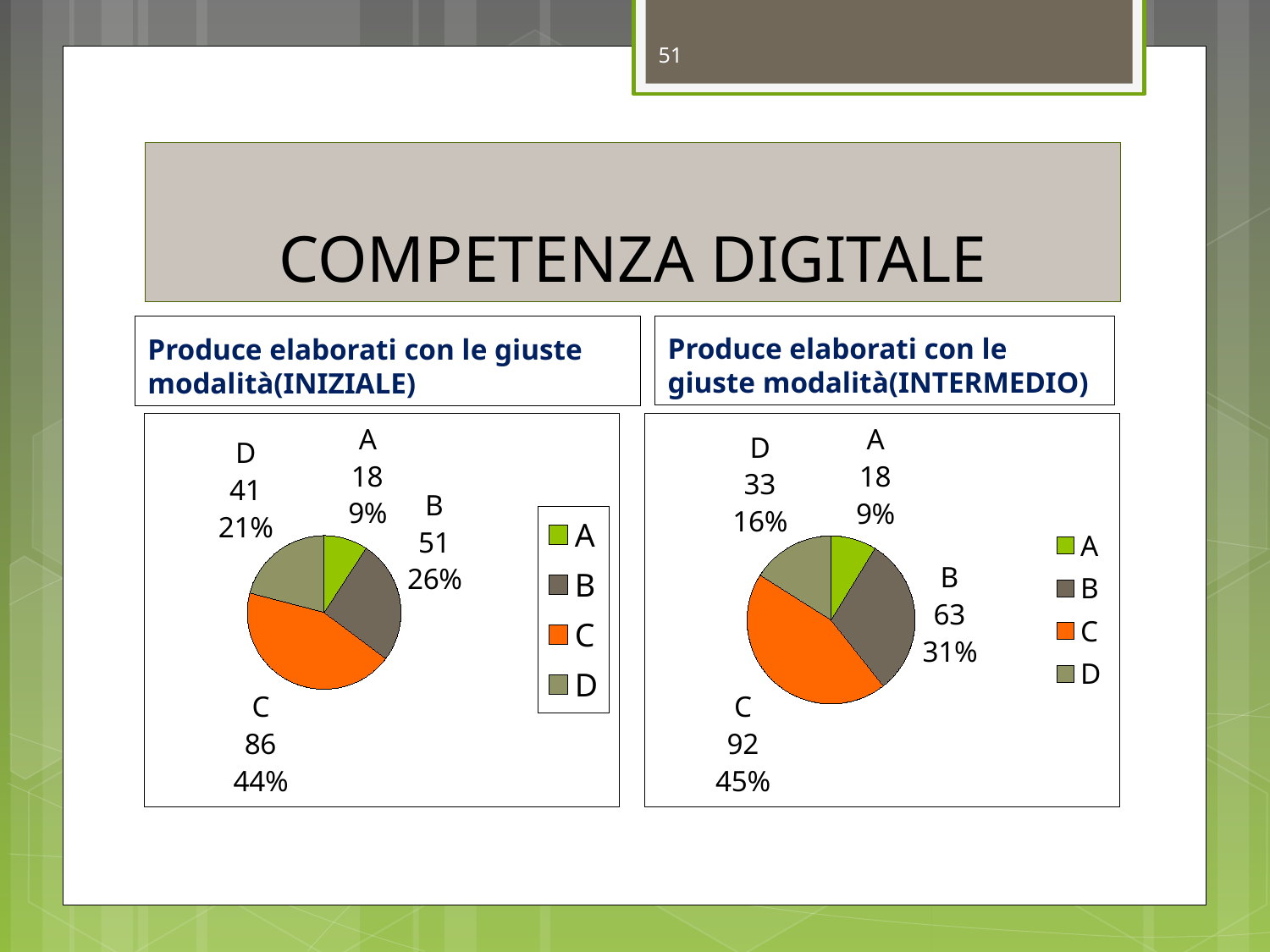
What type of chart is used on the right side of the slide (INTERMEDIO)? Pie chart How many entries does the legend of the INTERMEDIO pie chart (right) list? 4 In the INIZIALE pie chart (left), what colour is the slice for category C? Orange In the INTERMEDIO pie chart (right), which is larger, the value for B or the value for D? B In the INTERMEDIO pie chart (right), what is the value for category D? 33 In the INIZIALE pie chart (left), what percentage share does category D have? 21% In the INTERMEDIO pie chart (right), which category has the smallest value? A In the INTERMEDIO pie chart (right), what percentage share does category B have? 31% In the INIZIALE pie chart (left), what is the difference between the values for C and B? 35 In the INIZIALE pie chart (left), what is the value for category C? 86 In the INIZIALE pie chart (left), which category has the largest value? C How many categories does the INIZIALE pie chart (left) show? 4